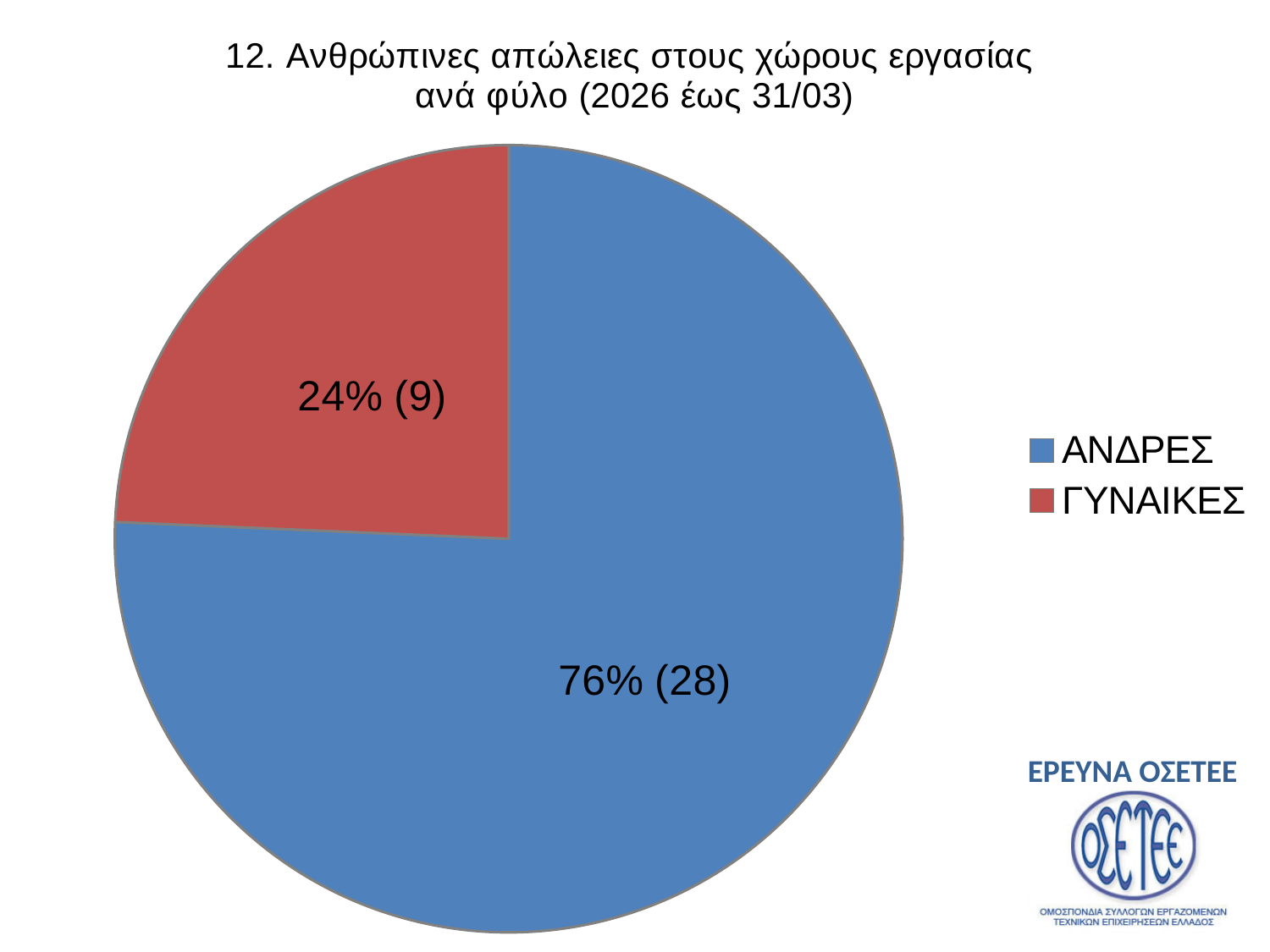
What is the difference in count between ΑΝΔΡΕΣ and ΓΥΝΑΙΚΕΣ? 19 What is the count shown for ΑΝΔΡΕΣ? 28 What is the total count across both slices of the pie? 37 What percentage share does ΓΥΝΑΙΚΕΣ have in the pie chart? 24% Which category has the largest slice of the pie? ΑΝΔΡΕΣ Which is larger, the share for ΑΝΔΡΕΣ or the share for ΓΥΝΑΙΚΕΣ? ΑΝΔΡΕΣ How many categories does the pie chart show? 2 What is the count shown for ΓΥΝΑΙΚΕΣ? 9 Which category has the smallest slice of the pie? ΓΥΝΑΙΚΕΣ What percentage share does ΑΝΔΡΕΣ have in the pie chart? 76% What kind of chart is shown on the slide? pie chart What colour is the slice for ΓΥΝΑΙΚΕΣ? red